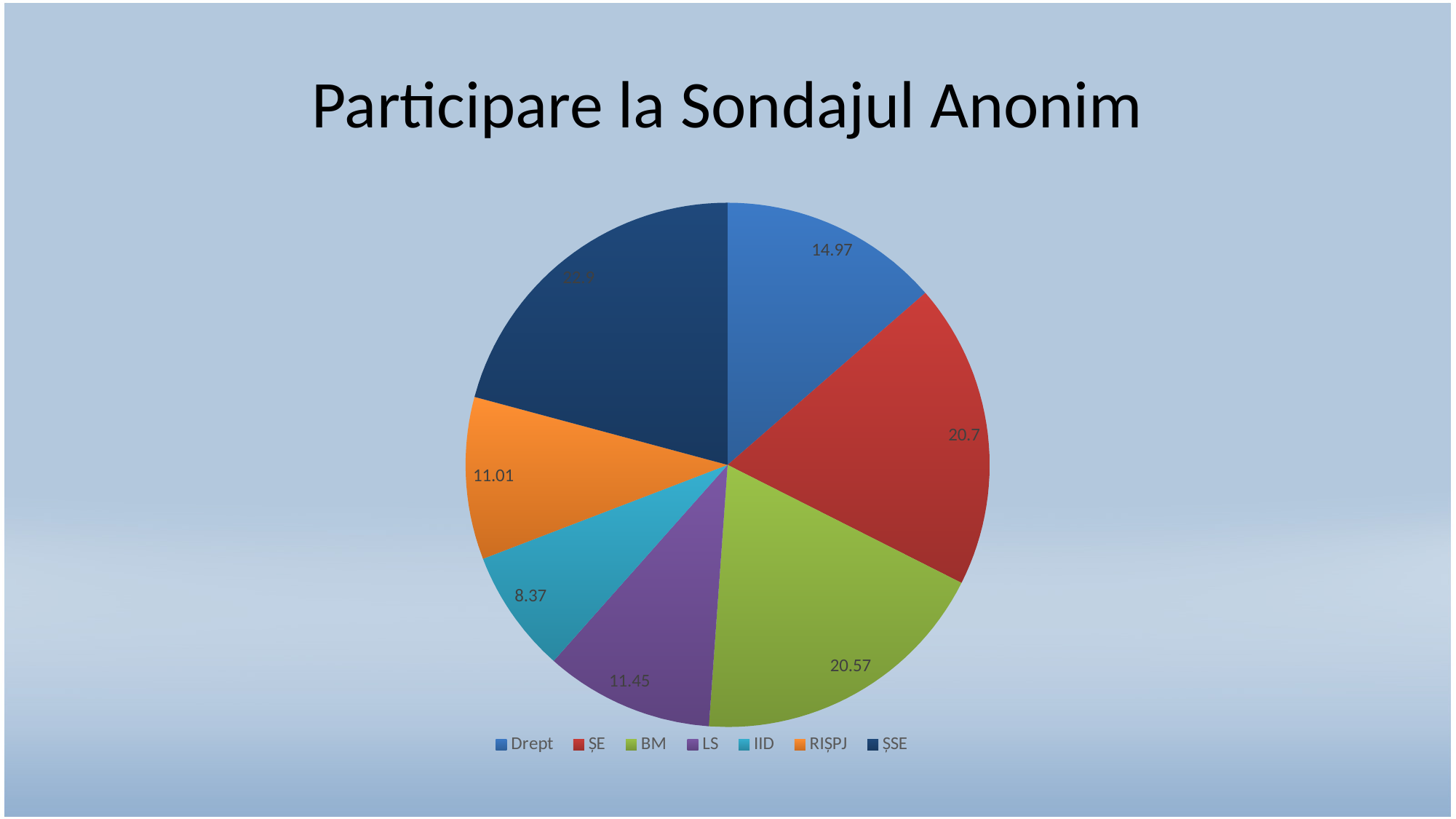
What is the value for RIȘPJ? 11.01 What is the value for LS? 11.45 What type of chart is shown on the slide? pie chart What is the title of the chart? Participare la Sondajul Anonim What is the value for Drept? 14.97 What is the value for ȘE? 20.7 Which category has the smallest slice? IID Which is larger, the value for Drept or the value for LS? Drept What is the value for IID? 8.37 What is the value for BM? 20.57 How many categories does the pie chart have? 7 What is the difference between the values for Drept and LS? 3.52